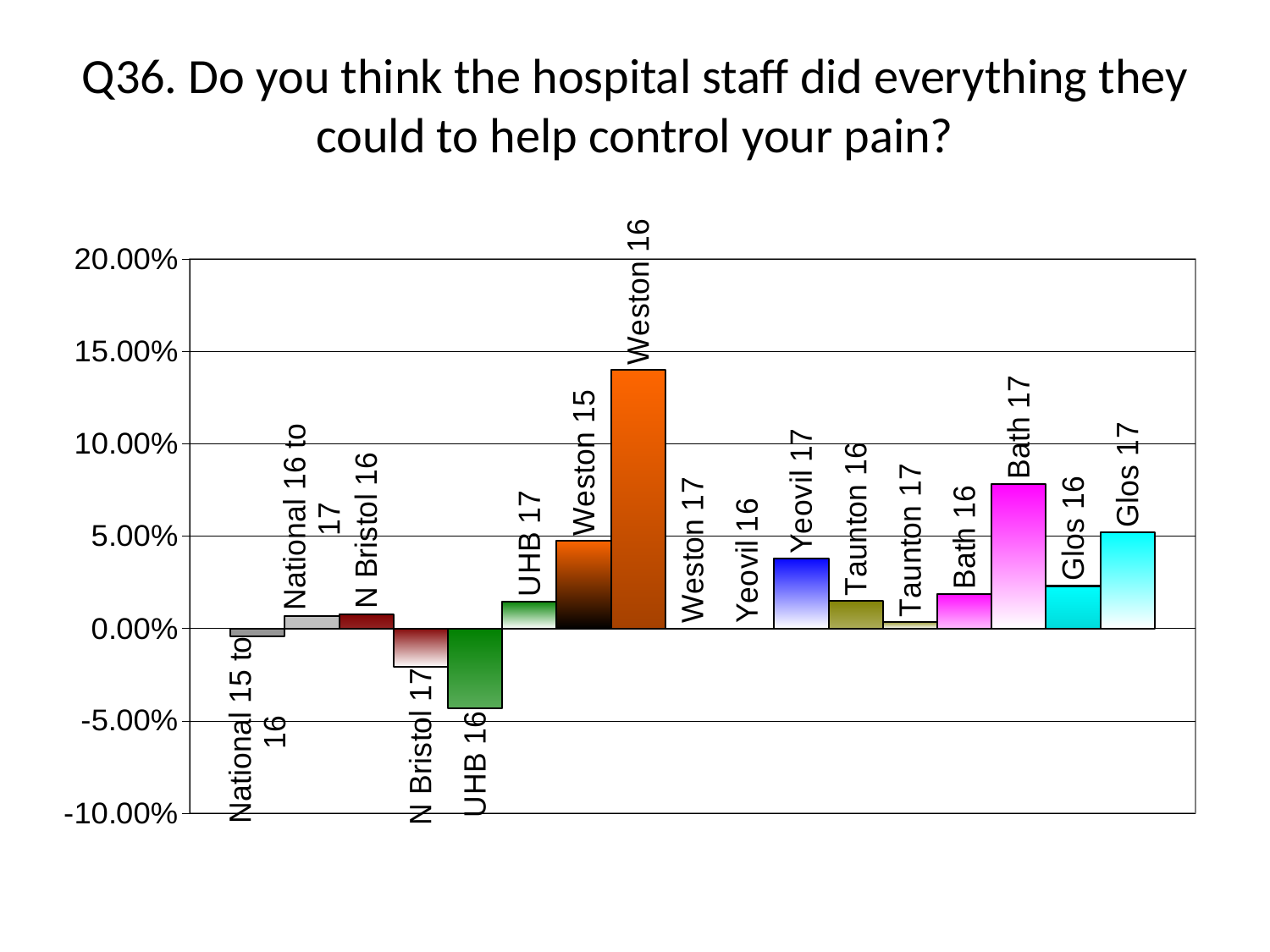
Is the value for Weston 16 greater or less than 10.00%? greater Is the value for UHB 16 greater or less than 0.00%? less Which is larger, the value for Bath 16 or Bath 17? Bath 17 Is the value for N Bristol 17 greater or less than 0.00%? less What kind of chart is shown on the slide? bar chart Which category has the highest value? Weston 16 What is the title of the chart? Q36. Do you think the hospital staff did everything they could to help control your pain? Which is larger, the value for UHB 16 or UHB 17? UHB 17 Which category has the lowest value? UHB 16 How many categories are shown on the x axis? 17